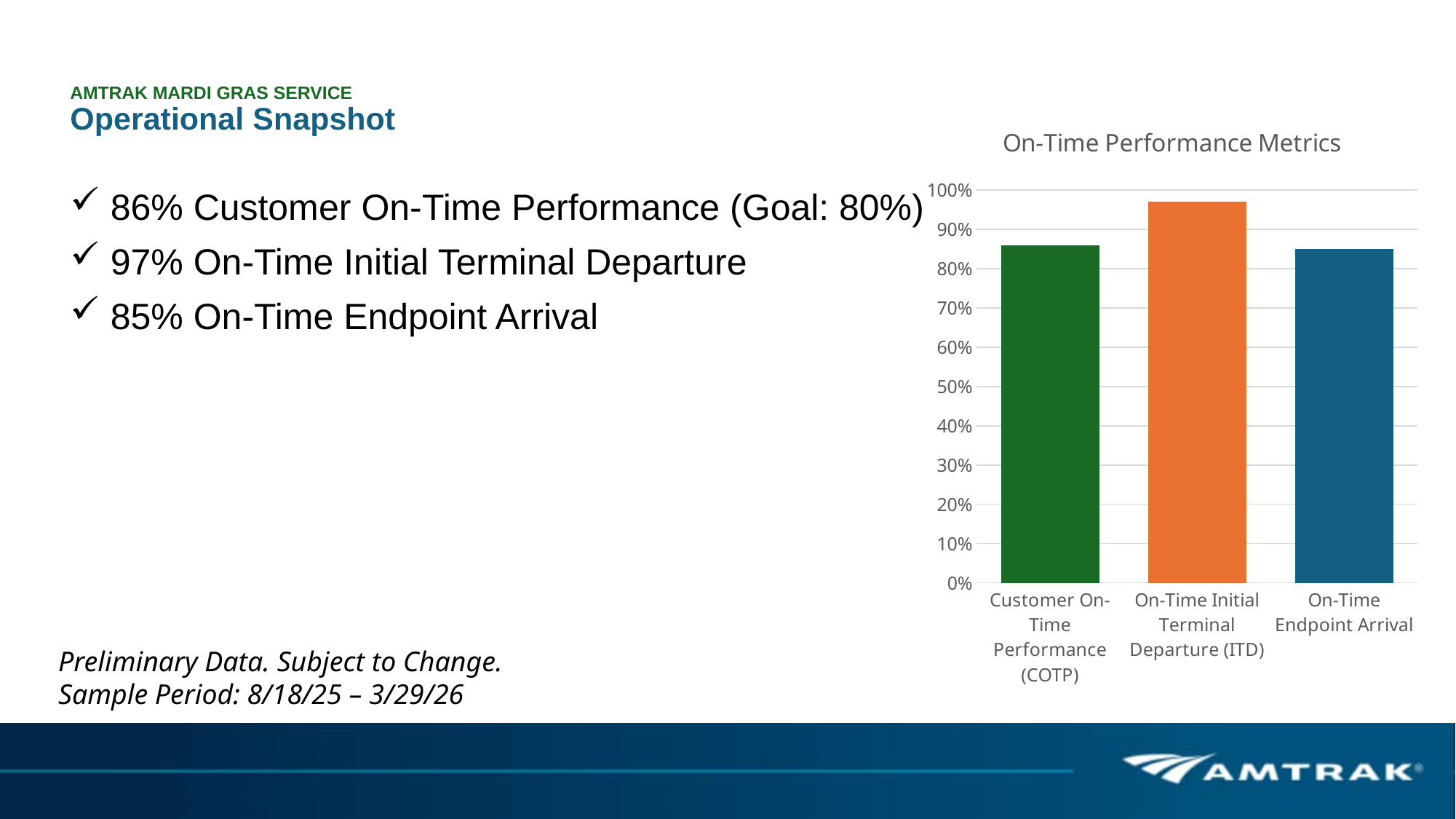
How many categories are plotted in the chart? 3 What is the value for Customer On-Time Performance (COTP)? 86% What is the value for On-Time Endpoint Arrival? 85% Which category has the highest value in the chart? On-Time Initial Terminal Departure (ITD) Is the value for Customer On-Time Performance (COTP) greater or less than 90%? less Is the value for On-Time Initial Terminal Departure (ITD) greater or less than 90%? greater Is the value for On-Time Endpoint Arrival greater or less than 80%? greater What is the title of the chart? On-Time Performance Metrics Which is larger: On-Time Initial Terminal Departure (ITD) or On-Time Endpoint Arrival? On-Time Initial Terminal Departure (ITD) What type of chart is shown on the slide? bar chart What is the value for On-Time Initial Terminal Departure (ITD)? 97% What is the difference between On-Time Initial Terminal Departure (ITD) and On-Time Endpoint Arrival? 12%